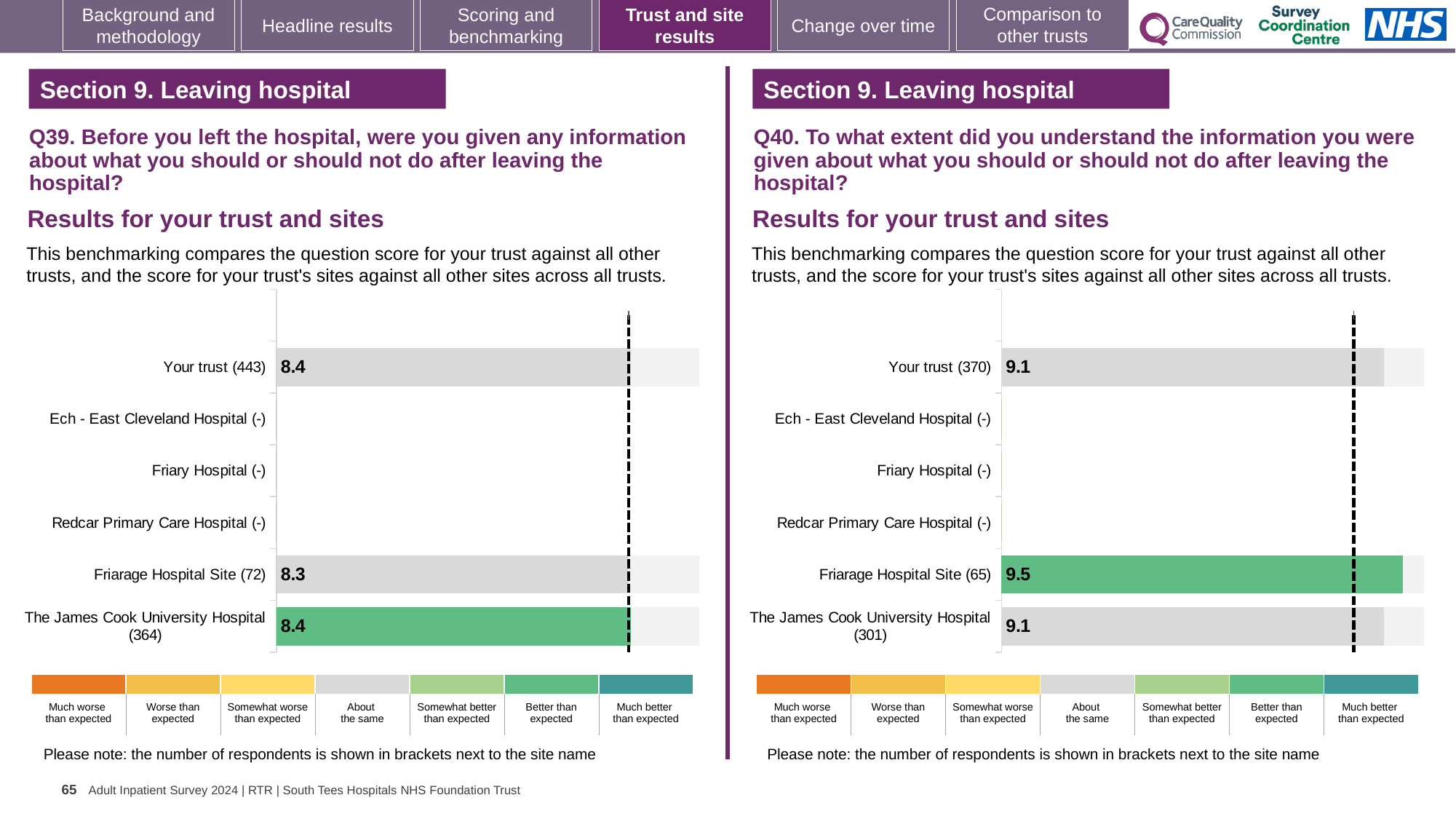
In the Q39 chart on the left, what is the difference between the Your trust score and the Friarage Hospital Site score? 0.1 In the Q39 chart on the left, what is the score for The James Cook University Hospital (364)? 8.4 How many site or trust categories are listed on the y axis of the Q39 chart on the left? 6 In the Q39 chart on the left, what is the score for Friarage Hospital Site (72)? 8.3 What kind of chart is used for the Q40 results on the right? Bar chart In the Q40 chart on the right, which site has the highest score? Friarage Hospital Site (65) In the Q40 chart on the right, which is larger: the score for Friarage Hospital Site (65) or the score for The James Cook University Hospital (301)? Friarage Hospital Site (65) In the Q40 chart on the right, what is the score for Your trust (370)? 9.1 In the Q40 chart on the right, what is the score for Friarage Hospital Site (65)? 9.5 In the Q39 chart on the left, what is the score for Your trust (443)? 8.4 In the Q40 chart on the right, what is the difference between the Friarage Hospital Site score and the Your trust score? 0.4 In the Q40 chart on the right, what is the score for The James Cook University Hospital (301)? 9.1